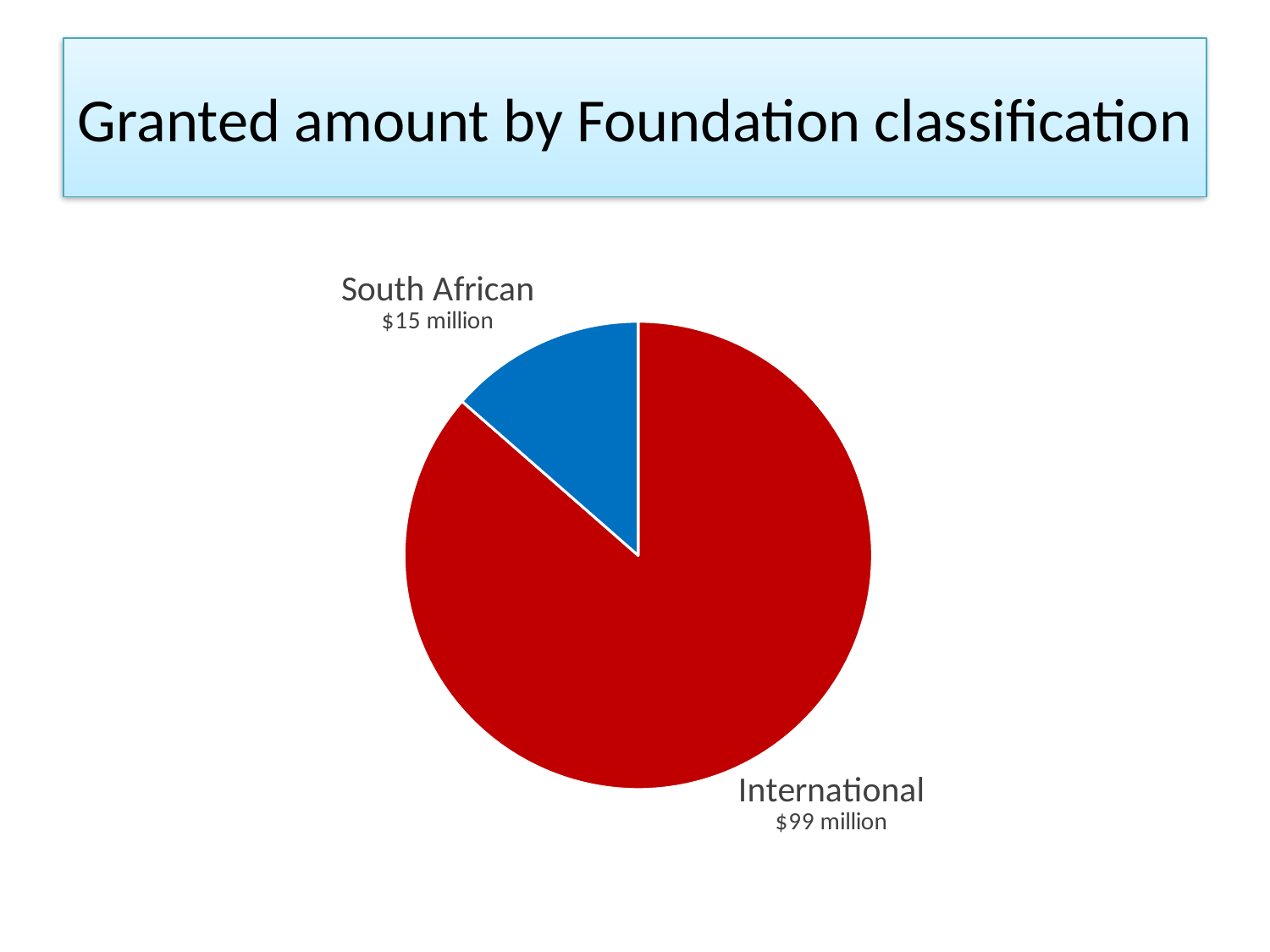
What is the difference in granted amount between International and South African foundations? $84 million Which has a larger granted amount, South African or International foundations? International What colour is the International slice of the pie chart? Red What is the granted amount for International foundations? $99 million What kind of chart is shown on the slide? Pie chart What is the total granted amount across both foundation classifications? $114 million What is the title of the chart on the slide? Granted amount by Foundation classification Which foundation classification has the largest granted amount? International Which foundation classification has the smallest granted amount? South African What is the granted amount for South African foundations? $15 million How many slices does the pie chart have? 2